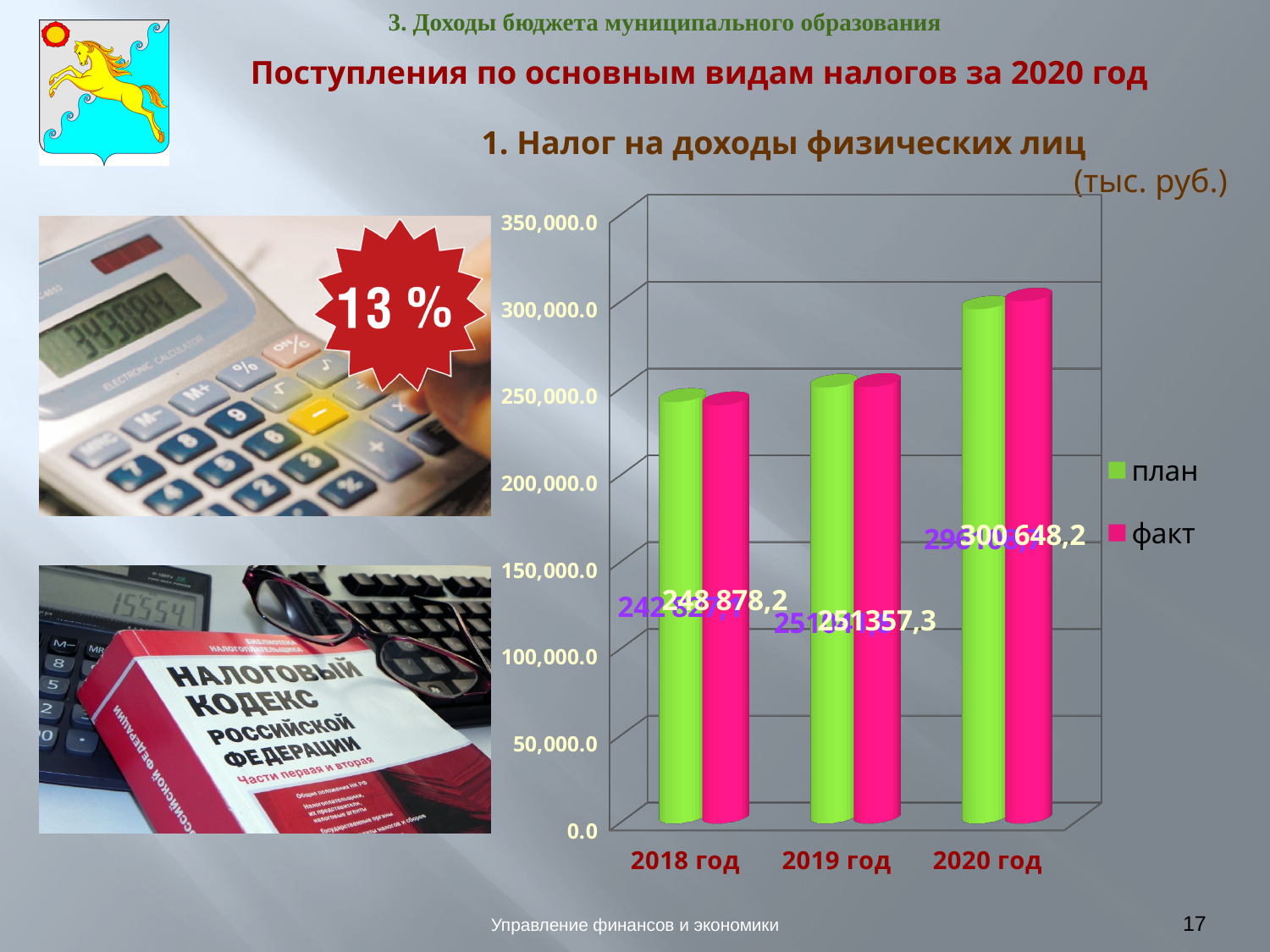
What is the факт value for 2018 год? 248 878,2 How many series does the legend list? 2 How many years are shown on the x axis? 3 Do the факт values rise or fall from 2018 год to 2020 год? rise Is the план value for 2018 год greater or less than 250,000.0? less In which year is the факт value highest? 2020 год Which is larger, the факт value for 2019 год or for 2018 год? 2019 год In which year is the факт value lowest? 2018 год What is the факт value for 2020 год? 300 648,2 What is the факт value for 2019 год? 251 357,3 What kind of chart is shown? bar chart What is the difference between the факт values for 2020 год and 2018 год? 51 770,0